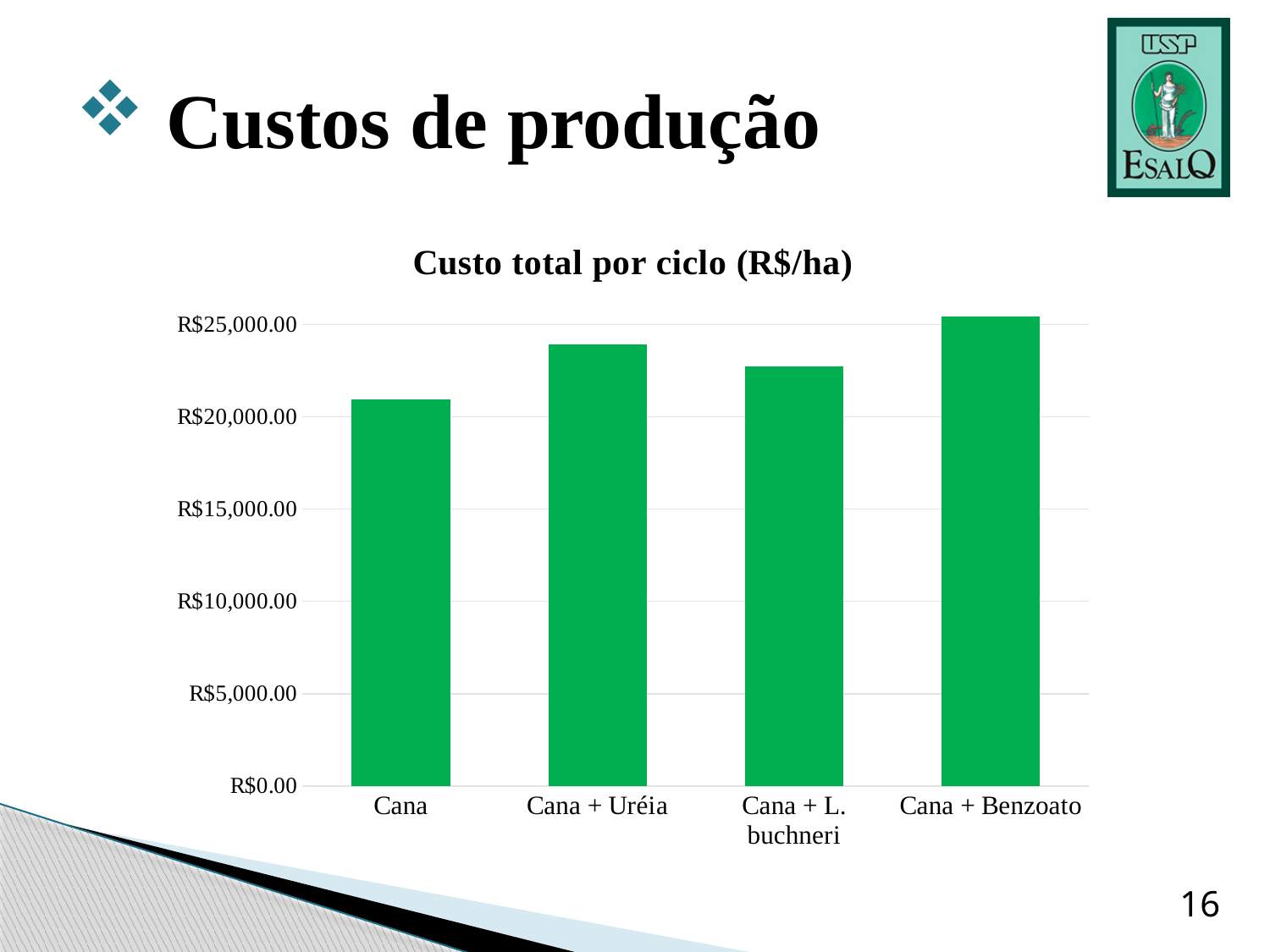
Which has a higher total cost per cycle, Cana or Cana + Benzoato? Cana + Benzoato What kind of chart is shown on the slide? bar chart Is the value for Cana greater or less than R$20,000.00? greater How many categories are plotted in the chart? 4 Which category has the highest total cost per cycle? Cana + Benzoato What is the title of the chart? Custo total por ciclo (R$/ha) Which has a higher total cost per cycle, Cana + Uréia or Cana + L. buchneri? Cana + Uréia What colour are the bars in the chart? green Which category has the lowest total cost per cycle? Cana Is the value for Cana + L. buchneri greater or less than R$25,000.00? less Is the value for Cana + Benzoato greater or less than R$25,000.00? greater